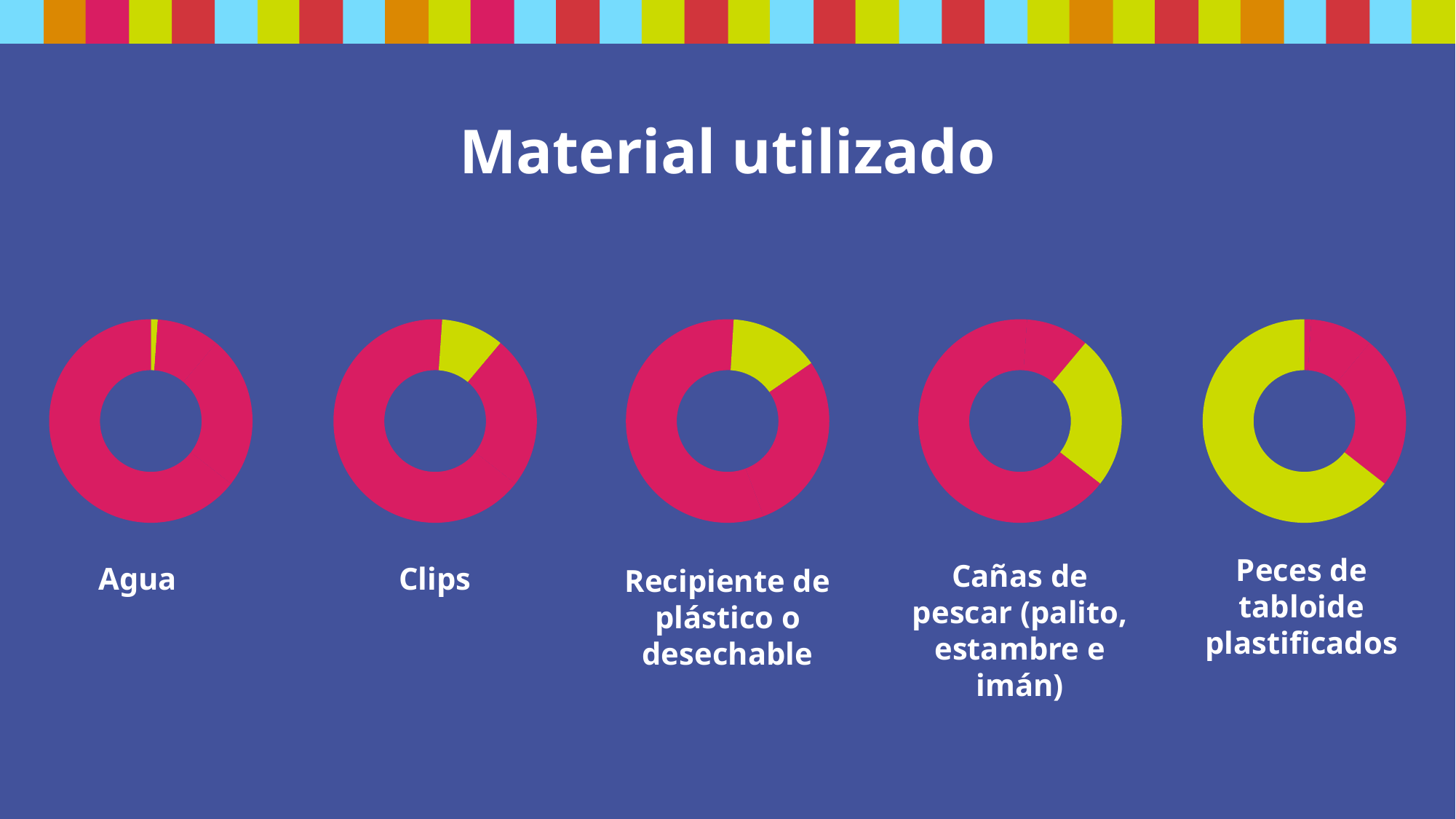
Which of the five donut charts has the largest yellow-green slice? Peces de tabloide plastificados What is the title of the slide containing the donut charts? Material utilizado What kind of chart is used for each of the five materials on the slide? Donut (pie) chart What is the label of the fourth donut chart from the left? Cañas de pescar (palito, estambre e imán) Which of the five donut charts has the smallest yellow-green slice? Agua How many donut charts are shown on the slide? 5 Is the yellow-green slice larger in the Agua chart or in the Recipiente de plástico o desechable chart? Recipiente de plástico o desechable In the Peces de tabloide plastificados chart, which colour slice is larger, magenta or yellow-green? Yellow-green Is the yellow-green slice larger in the Clips chart or in the Cañas de pescar (palito, estambre e imán) chart? Cañas de pescar (palito, estambre e imán) Which of the five donut charts has the largest magenta slice? Agua Which of the five donut charts has the smallest magenta slice? Peces de tabloide plastificados